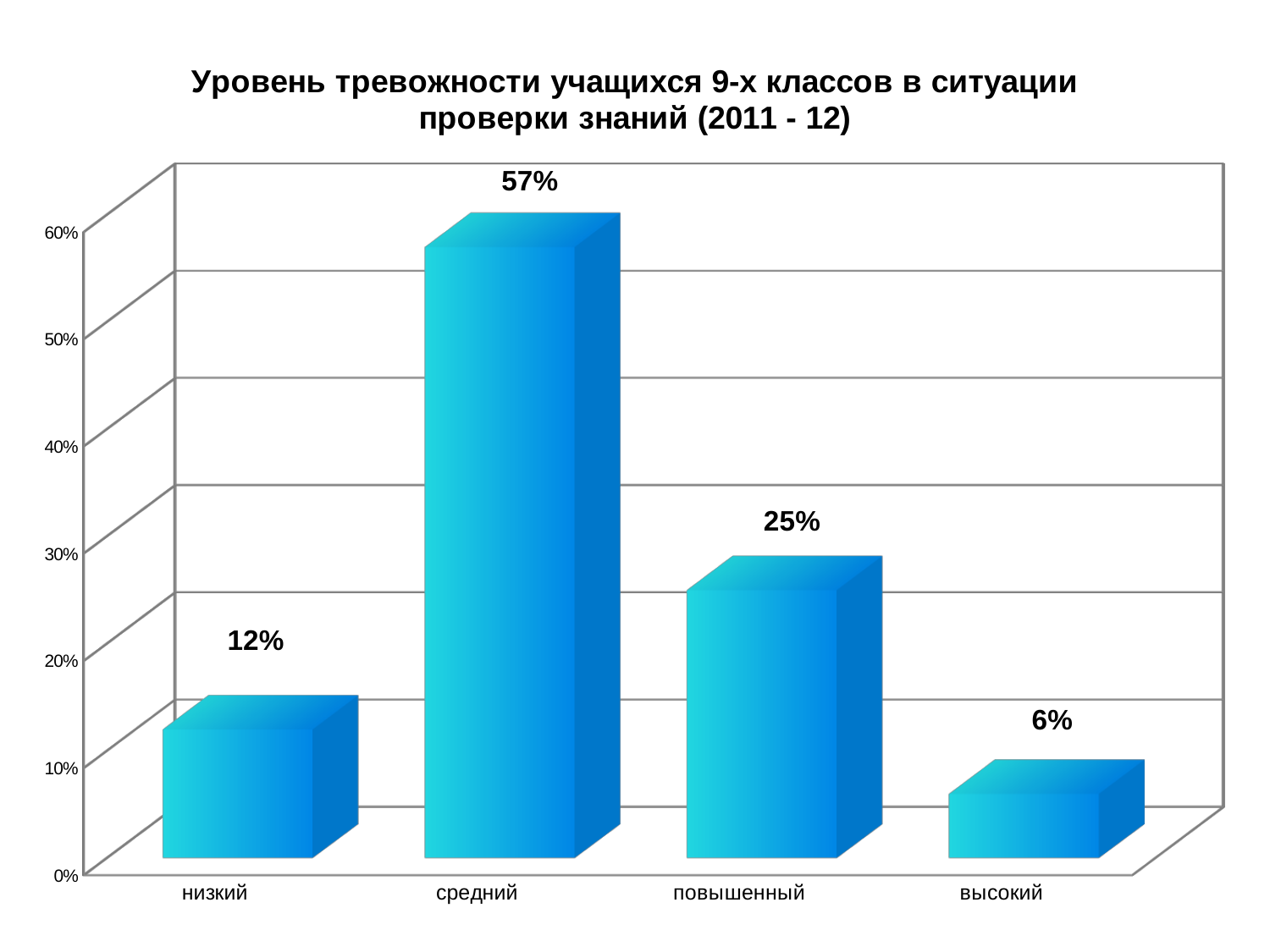
What is the value for the 'высокий' category? 6% Which category has the lowest value? высокий Which is larger, the value for 'низкий' or the value for 'повышенный'? повышенный Which category has the highest value? средний How many categories are shown on the x axis? 4 Is the value for 'повышенный' greater or less than 30%? less What is the value for the 'средний' category? 57% What is the difference between the values for 'средний' and 'повышенный'? 32% What is the difference between the values for 'низкий' and 'высокий'? 6% What kind of chart is shown on the slide? bar chart What is the value for the 'низкий' category? 12% What is the value for the 'повышенный' category? 25%